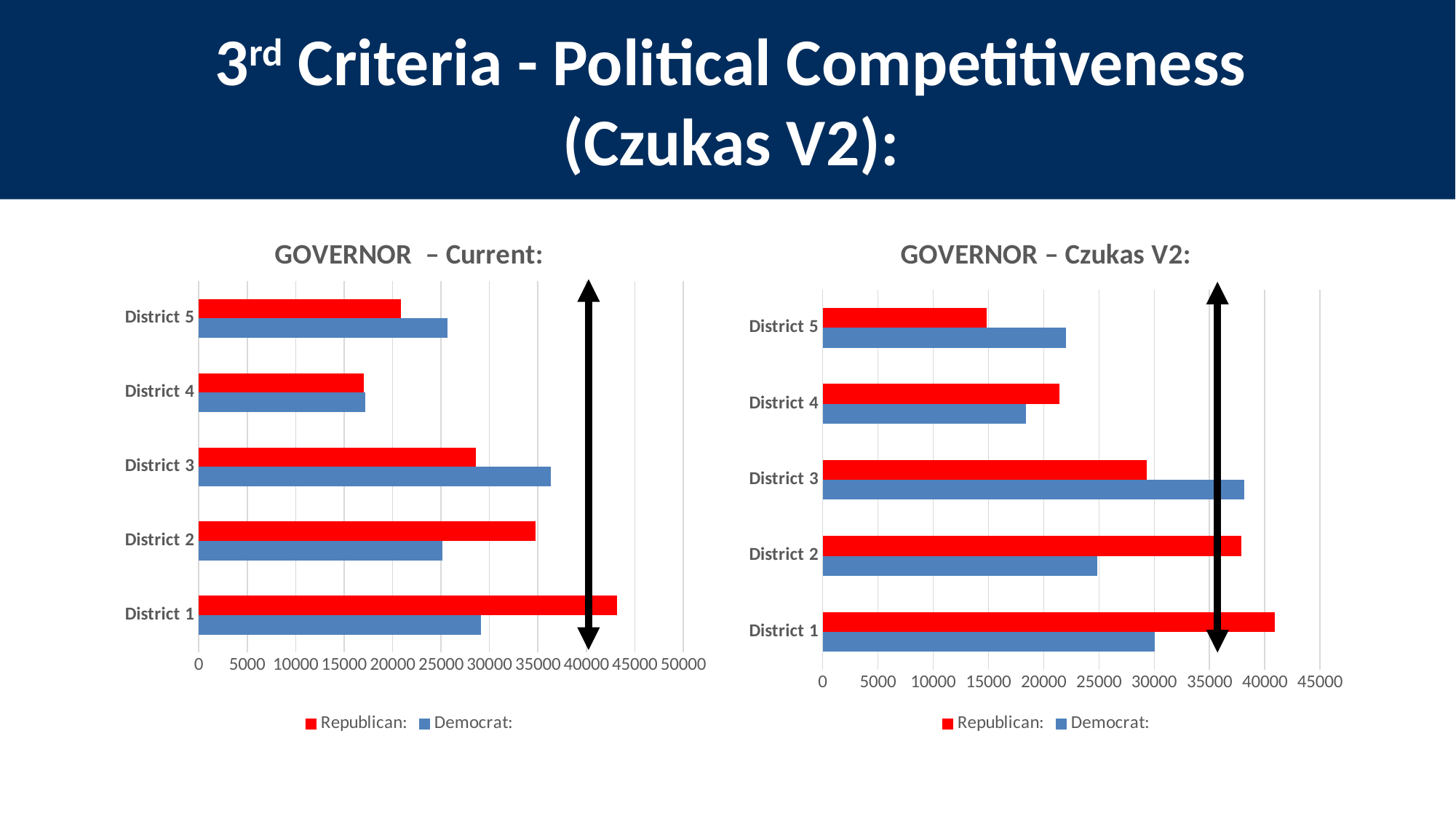
On the GOVERNOR – Czukas V2 chart, what colour represents the Republican series? red How many series does the legend of the GOVERNOR – Current chart list? 2 How many districts are shown on the GOVERNOR – Czukas V2 chart? 5 On the GOVERNOR – Czukas V2 chart, which district has the highest Republican value? District 1 On the GOVERNOR – Current chart, which district has the lowest Republican value? District 4 On the GOVERNOR – Current chart, which district has the highest Republican value? District 1 On the GOVERNOR – Current chart, for District 2, which is larger: the Republican or the Democrat value? Republican On the GOVERNOR – Current chart, is the Republican value for District 1 greater or less than 40000? greater On the GOVERNOR – Current chart, is the Democrat value for District 3 greater or less than 30000? greater On the GOVERNOR – Czukas V2 chart, is the Republican value for District 5 greater or less than 20000? less What kind of chart is the GOVERNOR – Current chart on the left? bar chart On the GOVERNOR – Czukas V2 chart, which district has the lowest Republican value? District 5